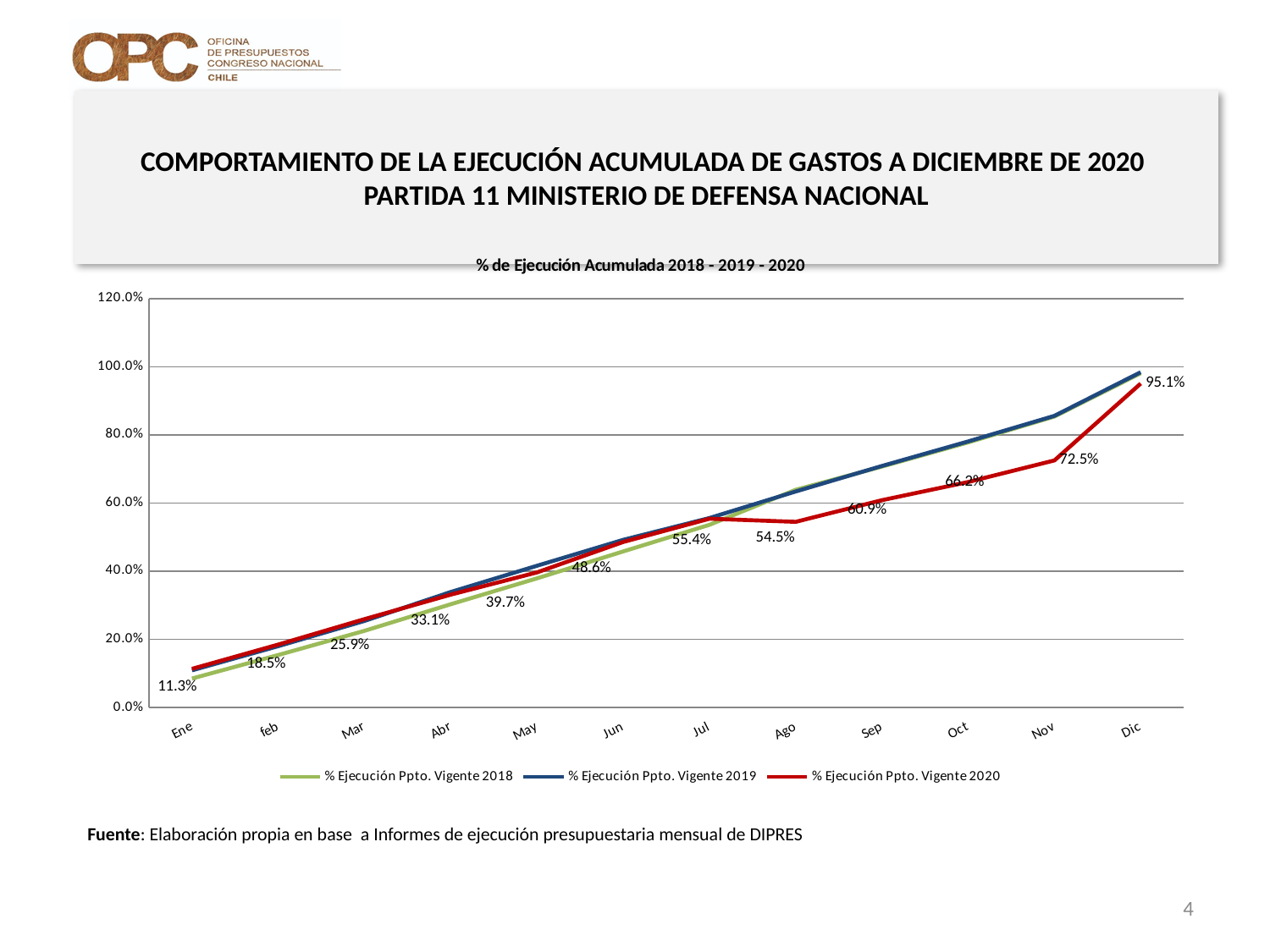
How many months are plotted along the x axis? 12 What is the value for % Ejecución Ppto. Vigente 2020 in Ene? 11.3% What is the difference between the Dic and Nov values for % Ejecución Ppto. Vigente 2020? 22.6 percentage points What is the value for % Ejecución Ppto. Vigente 2020 in Jul? 55.4% What is the value for % Ejecución Ppto. Vigente 2020 in Dic? 95.1% What is the title of the chart? % de Ejecución Acumulada 2018 - 2019 - 2020 For % Ejecución Ppto. Vigente 2020, which is larger, the Jul value or the Ago value? Jul What kind of chart is shown on the slide? line chart In which month does % Ejecución Ppto. Vigente 2020 reach its highest value? Dic What is the value for % Ejecución Ppto. Vigente 2020 in Ago? 54.5% How many series does the legend list? 3 Is the value for % Ejecución Ppto. Vigente 2019 in Dic greater or less than 80.0%? greater